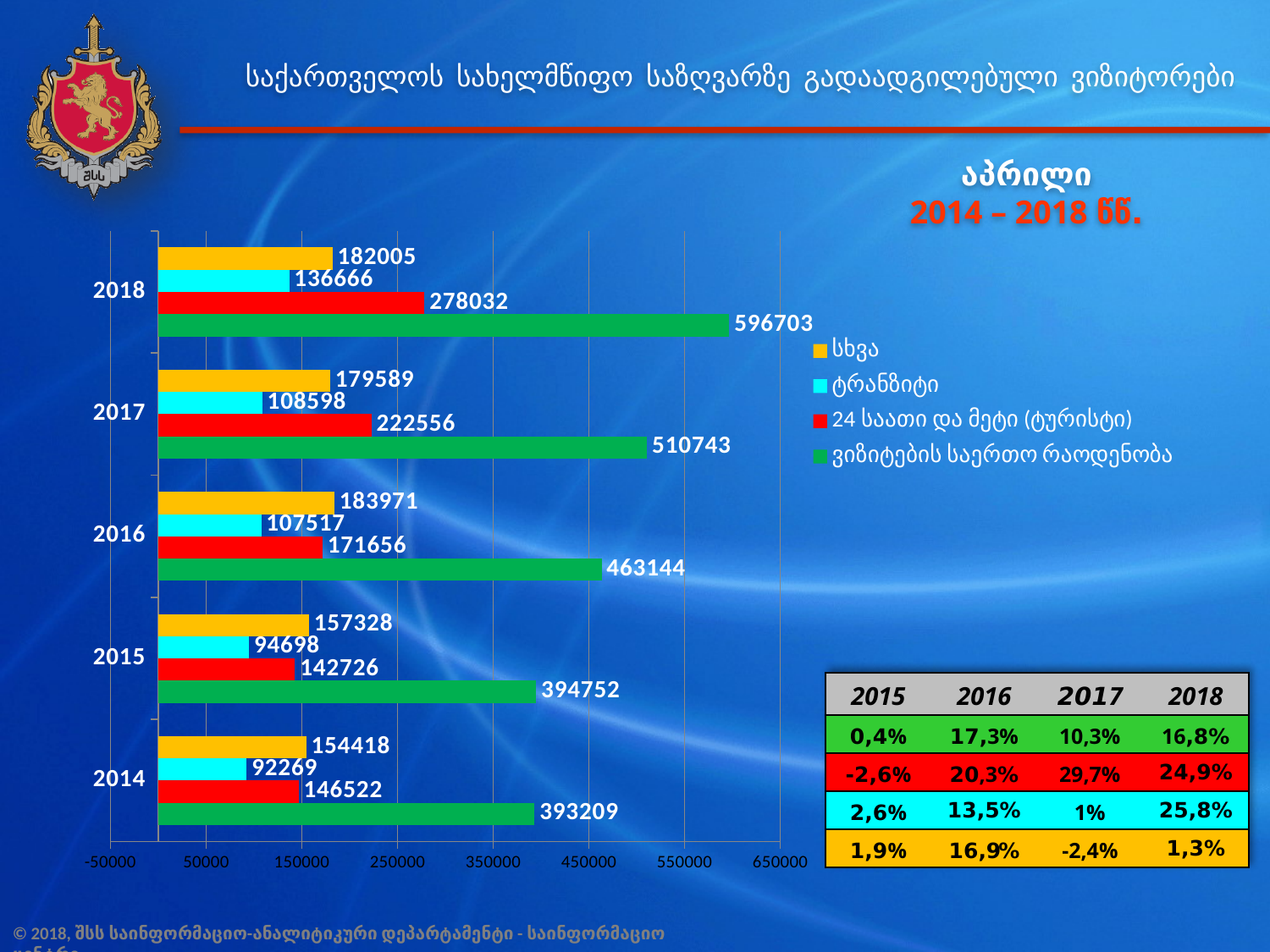
Which year has the highest value for ვიზიტების საერთო რაოდენობა? 2018 How many years are shown on the chart? 5 What is the value of the 24 საათი და მეტი (ტურისტი) (red) bar for 2017? 222556 What is the difference between the ვიზიტების საერთო რაოდენობა values for 2018 and 2017? 85960 What is the value of the სხვა (yellow) bar for 2014? 154418 Is the ვიზიტების საერთო რაოდენობა value for 2016 greater or less than 450000? greater What is the value of the ვიზიტების საერთო რაოდენობა (green) bar for 2018? 596703 How many series does the legend list? 4 What is the value of the ტრანზიტი (cyan) bar for 2015? 94698 Which is larger: the 24 საათი და მეტი (ტურისტი) value for 2016 or the სხვა value for 2016? სხვა (183971) What type of chart is shown on the slide? Bar chart Which year has the lowest value for ტრანზიტი? 2014